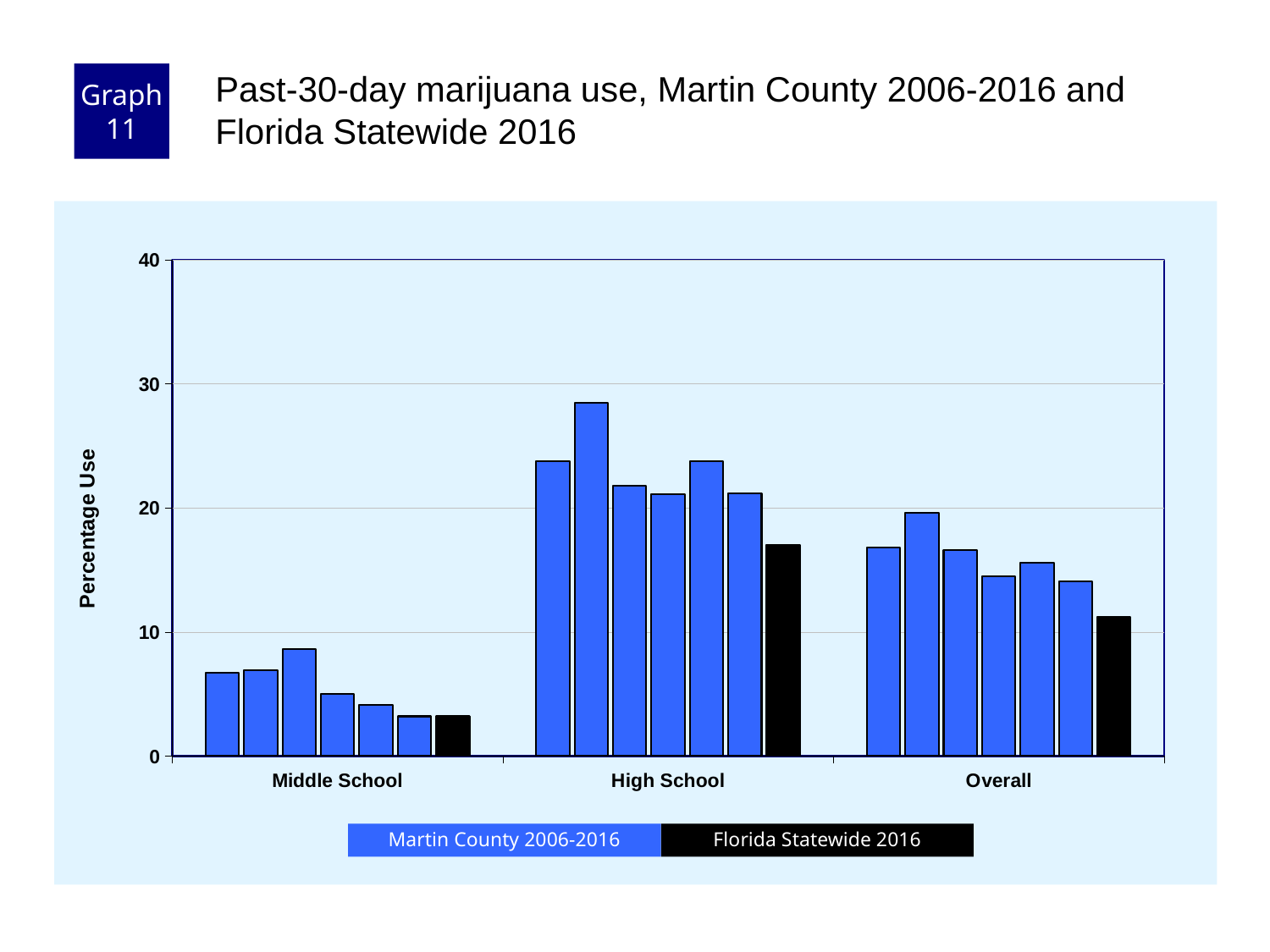
Do the Martin County bars for Middle School end higher or lower than they start? lower What colour are the Florida Statewide 2016 bars? black Which category has the lowest bars? Middle School How many categories are shown on the x axis? 3 Which category has the highest bars? High School Is the tallest Martin County bar for High School greater or less than 30? less How many series does the legend list? 2 Is the Florida Statewide 2016 value for Overall greater or less than 20? less Which is larger: the Florida Statewide 2016 value for High School or for Overall? High School Is the Florida Statewide 2016 value for Middle School greater or less than 10? less What kind of chart is shown on the slide? bar chart